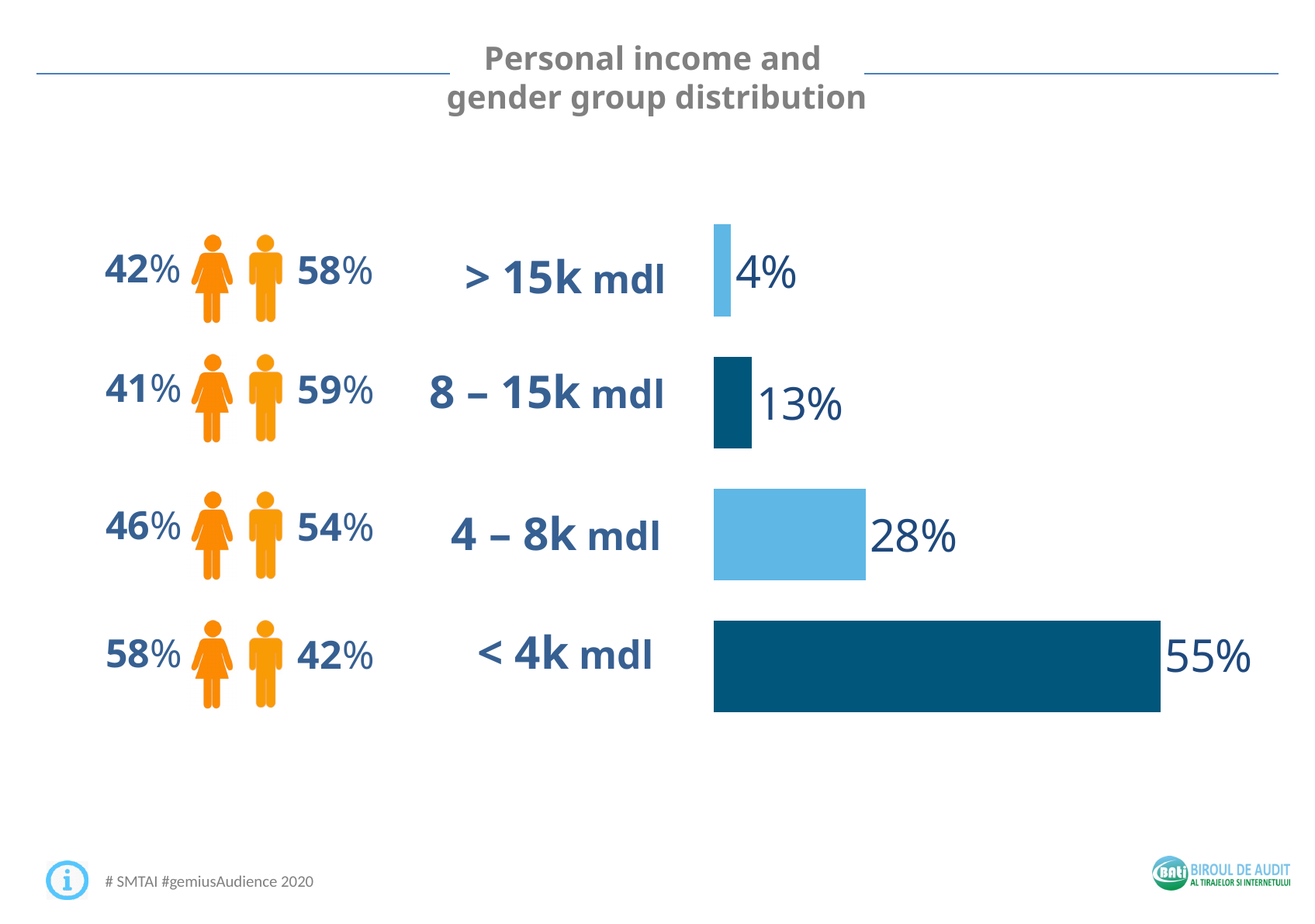
Which income group has the smallest share of the audience? > 15k mdl What share of the audience has a personal income of > 15k mdl? 4% Which is larger, the share for 4 – 8k mdl or the share for 8 – 15k mdl? 4 – 8k mdl Which income group has the largest share of the audience? < 4k mdl What percentage of the < 4k mdl income group is male? 42% What share of the audience has a personal income of < 4k mdl? 55% What is the difference between the shares for < 4k mdl and 4 – 8k mdl? 27% What kind of chart shows the income group distribution? Bar chart What is the title of the slide's chart? Personal income and gender group distribution What percentage of the 4 – 8k mdl income group is female? 46% What share of the audience has a personal income of 8 – 15k mdl? 13% How many income groups are shown in the bar chart? 4